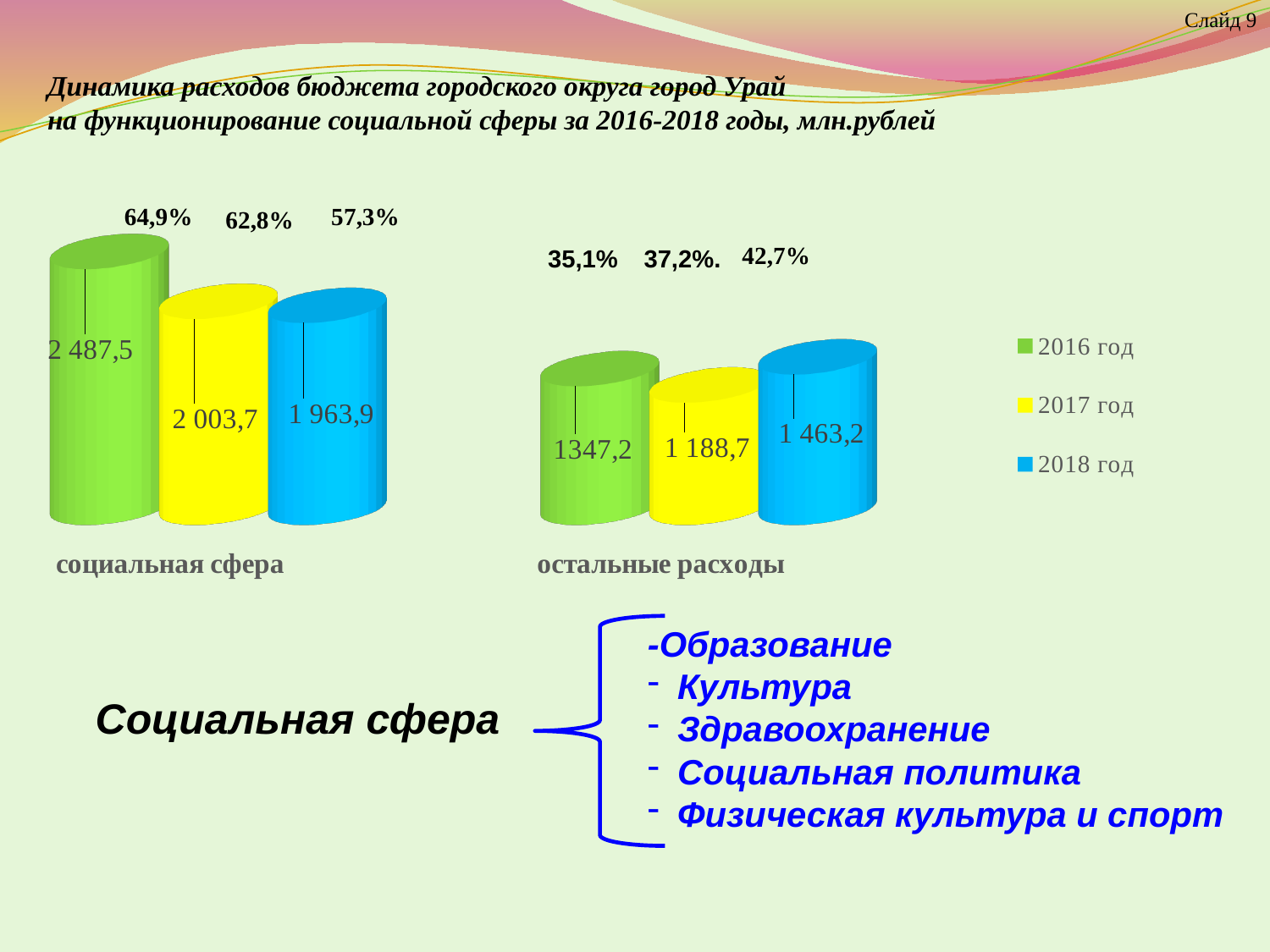
Which year has the highest value in the социальная сфера category? 2016 год Which is larger: the 2016 год value for социальная сфера or the 2018 год value for остальные расходы? 2016 год value for социальная сфера What is the value for 2018 год in the остальные расходы category? 1 463,2 How many series does the legend list? 3 What is the value for 2017 год in the социальная сфера category? 2 003,7 What is the difference between the 2018 год and 2017 год values in the остальные расходы category? 274,5 Which year has the lowest value in the остальные расходы category? 2017 год How many categories are shown on the x axis? 2 What kind of chart is shown on the slide? bar chart Do the values for социальная сфера rise or fall from 2016 год to 2018 год? fall What is the value for 2016 год in the социальная сфера category? 2 487,5 What is the difference between the 2016 год and 2017 год values in the социальная сфера category? 483,8